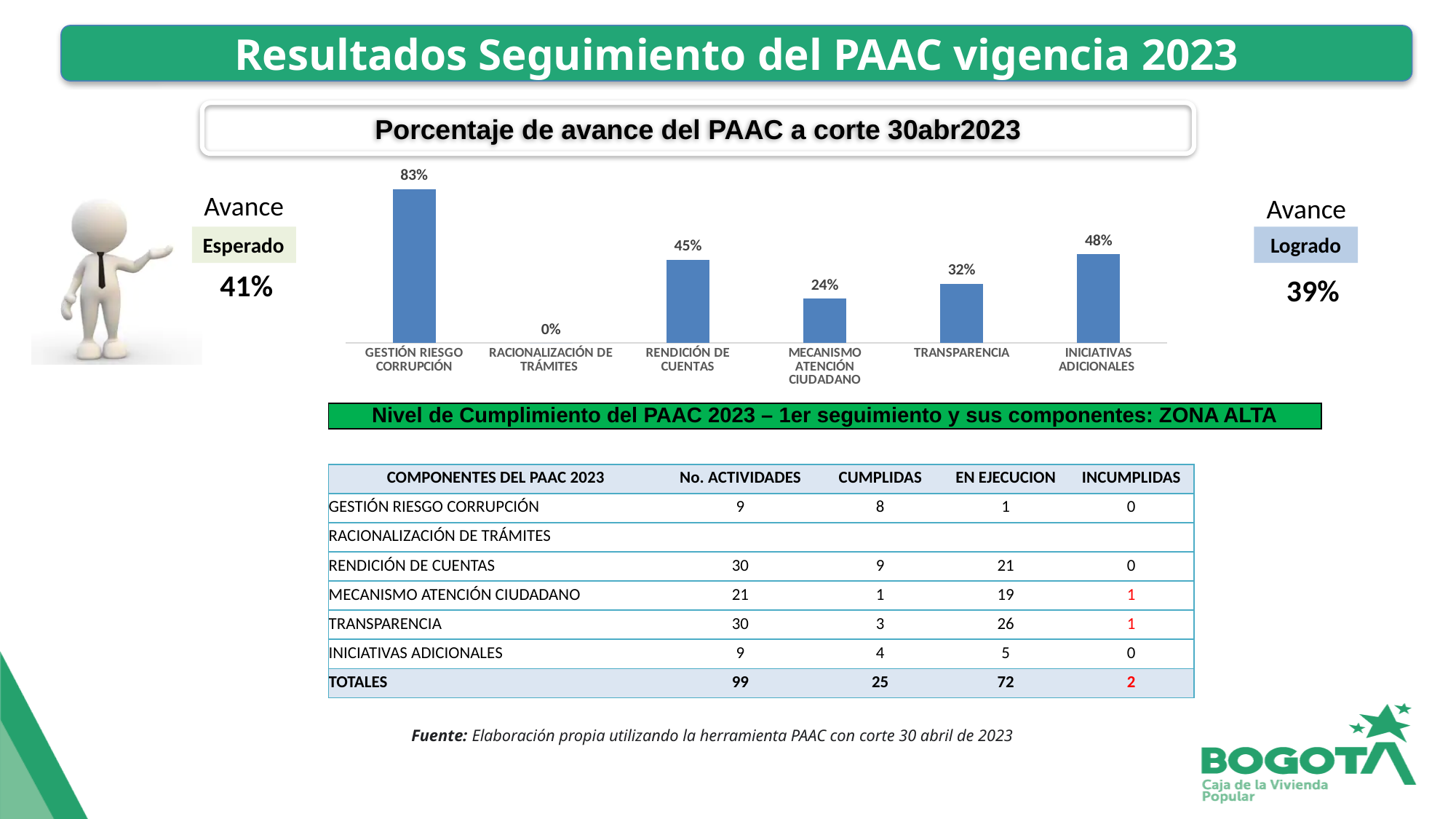
What is the title of the chart? Porcentaje de avance del PAAC a corte 30abr2023 What is the difference between the values for GESTIÓN RIESGO CORRUPCIÓN and INICIATIVAS ADICIONALES? 35% Which category has the lowest value in the chart? RACIONALIZACIÓN DE TRÁMITES Which category has the highest value in the chart? GESTIÓN RIESGO CORRUPCIÓN What is the value for MECANISMO ATENCIÓN CIUDADANO in the chart? 24% What is the value for RENDICIÓN DE CUENTAS in the chart? 45% What is the value for GESTIÓN RIESGO CORRUPCIÓN in the chart? 83% What kind of chart is shown on the slide? Bar chart Which is larger, the value for RENDICIÓN DE CUENTAS or the value for TRANSPARENCIA? RENDICIÓN DE CUENTAS How many categories are shown in the chart? 6 What is the value for INICIATIVAS ADICIONALES in the chart? 48% What is the value for TRANSPARENCIA in the chart? 32%